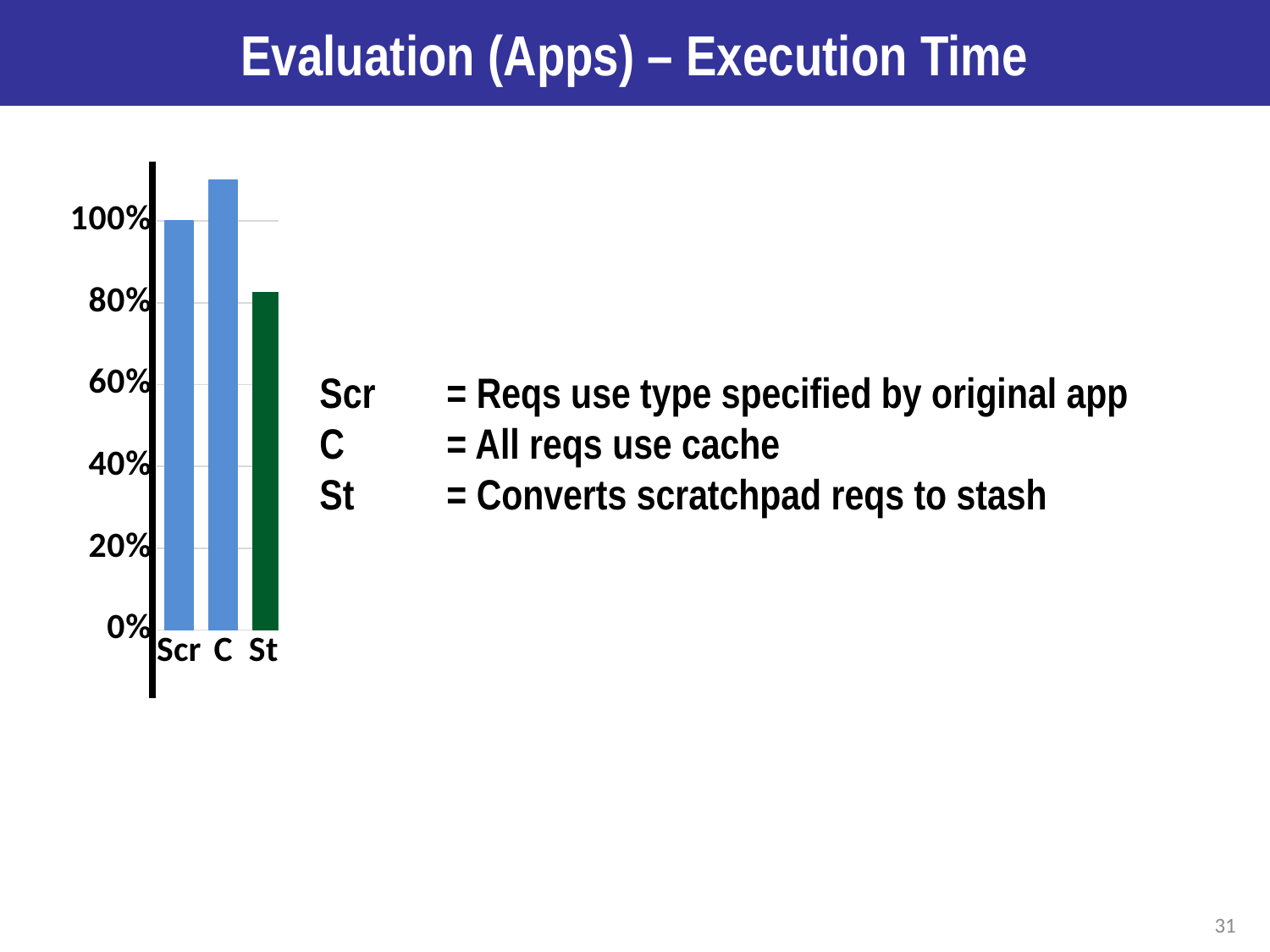
What colour is the bar for St? green Which is larger, the value for Scr or the value for St? Scr How many bars are plotted in the chart? 3 What is the value for Scr in the chart? 100% What kind of chart is shown on the slide? bar chart What is the label of the highest tick shown on the y axis? 100% Which category has the highest execution time in the chart? C Is the value for St greater or less than 60%? greater Which category has the lowest execution time in the chart? St Which is larger, the value for C or the value for St? C Is the value for C greater or less than 100%? greater Is the value for St greater or less than 100%? less